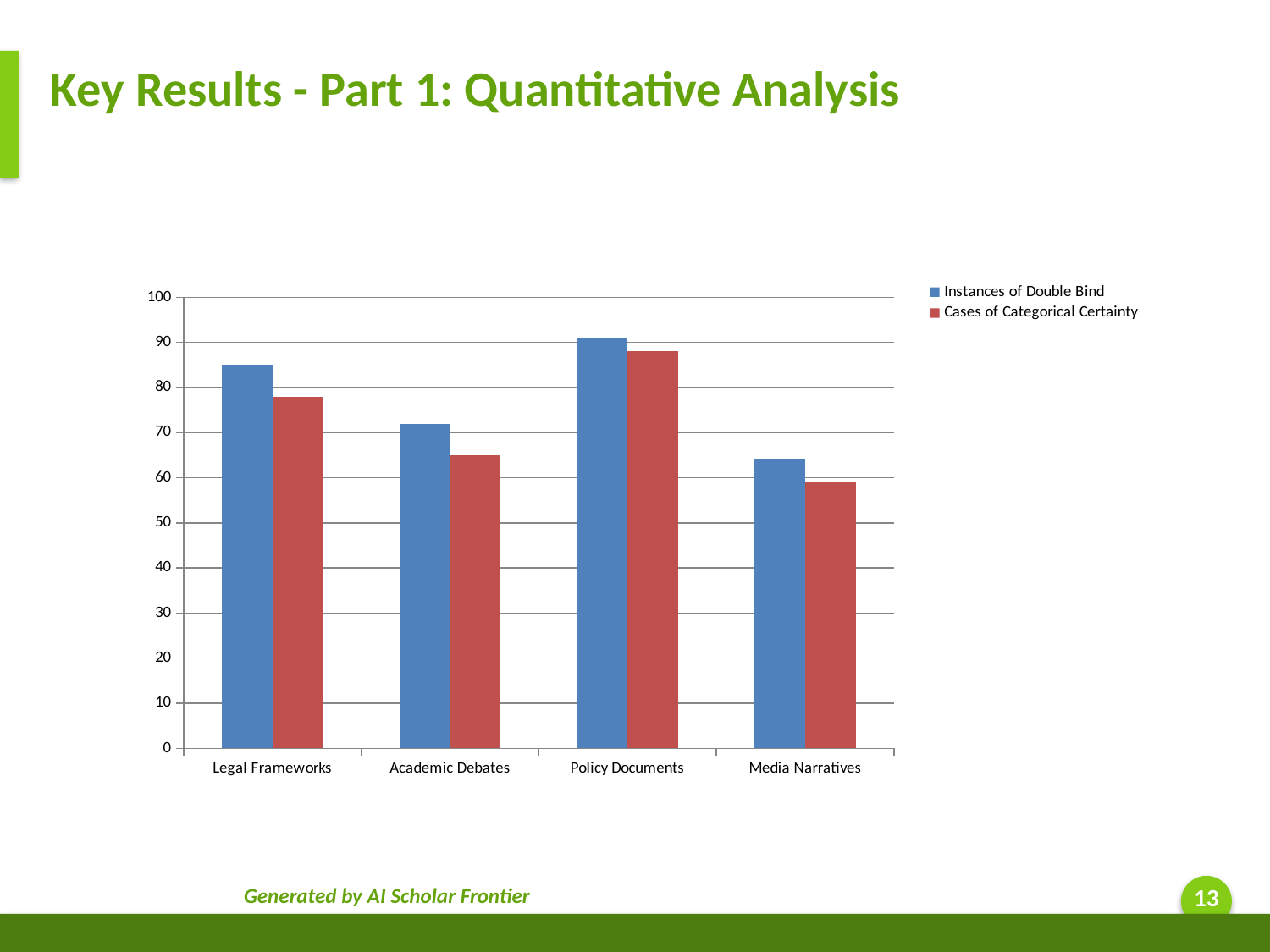
Is the value for Instances of Double Bind in Legal Frameworks greater or less than 80? greater Which category has the lowest value for Instances of Double Bind? Media Narratives How many series does the chart's legend list? 2 Which category has the highest value for Instances of Double Bind? Policy Documents Which is larger in Policy Documents: Instances of Double Bind or Cases of Categorical Certainty? Instances of Double Bind Is the value for Cases of Categorical Certainty in Media Narratives greater or less than 50? greater Which is larger: Instances of Double Bind for Academic Debates or Instances of Double Bind for Legal Frameworks? Legal Frameworks Which category has the lowest value for Cases of Categorical Certainty? Media Narratives What colour are the bars for Cases of Categorical Certainty? red Is the value for Cases of Categorical Certainty in Academic Debates greater or less than 70? less What kind of chart is shown on the slide? bar chart How many categories are shown on the x axis of the chart? 4